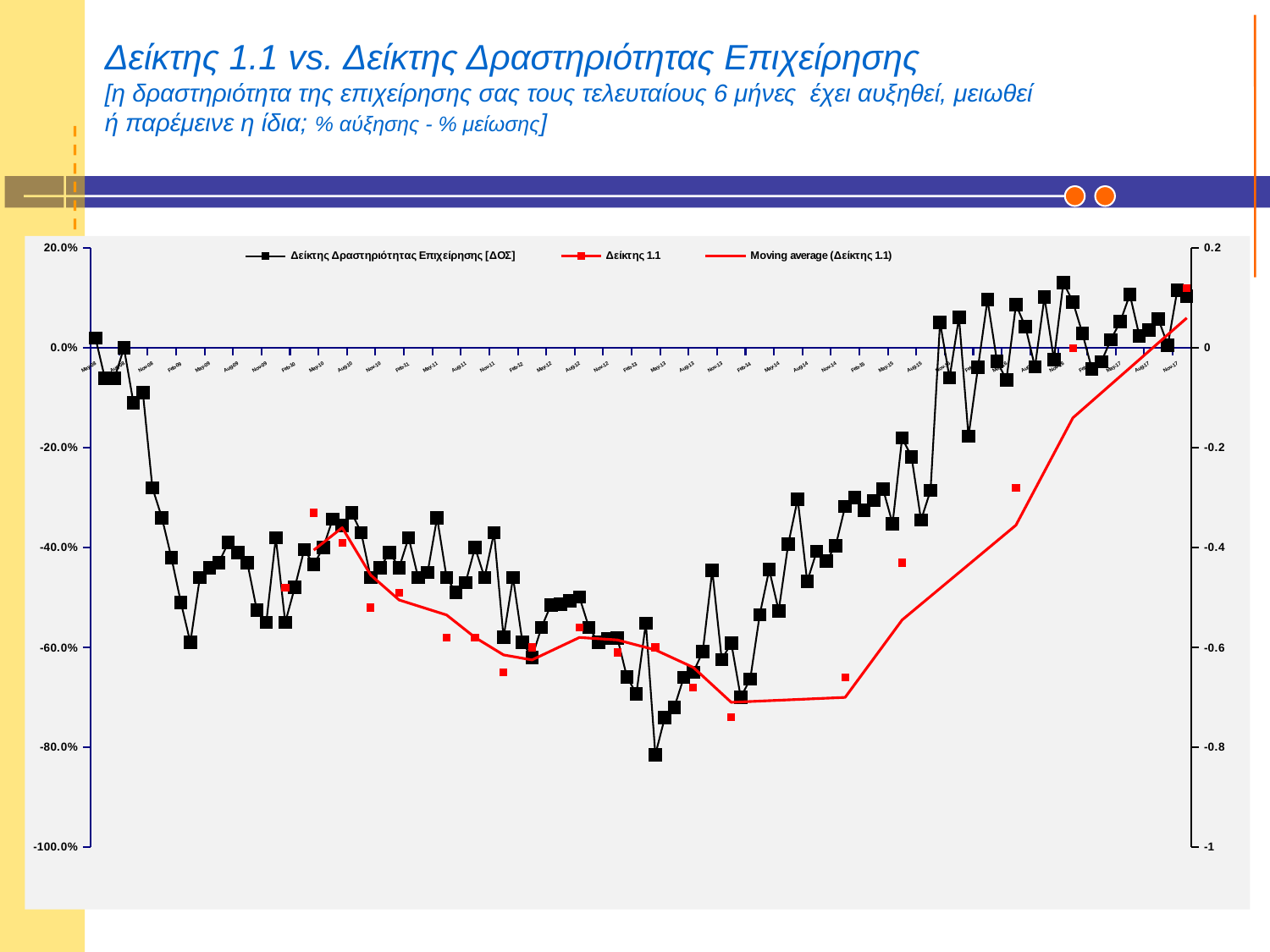
Which series is drawn as a black line with square markers? Δείκτης Δραστηριότητας Επιχείρησης [ΔΟΣ] Does the Δείκτης Δραστηριότητας Επιχείρησης [ΔΟΣ] line rise or fall between May08 and Feb09? Falls How many series does the chart's legend list? 3 Is the value of Δείκτης Δραστηριότητας Επιχείρησης [ΔΟΣ] at May08 greater or less than -20.0%? greater Is the value of Δείκτης Δραστηριότητας Επιχείρησης [ΔΟΣ] at Nov17 greater or less than 0.0%? greater Does the Moving average (Δείκτης 1.1) line rise or fall between Feb14 and Nov17? Rises Is the lowest point of the Δείκτης Δραστηριότητας Επιχείρησης [ΔΟΣ] line greater or less than -60.0%? less What kind of chart is shown on the slide? Line chart What is the lowest value shown on the left vertical axis? -100.0%